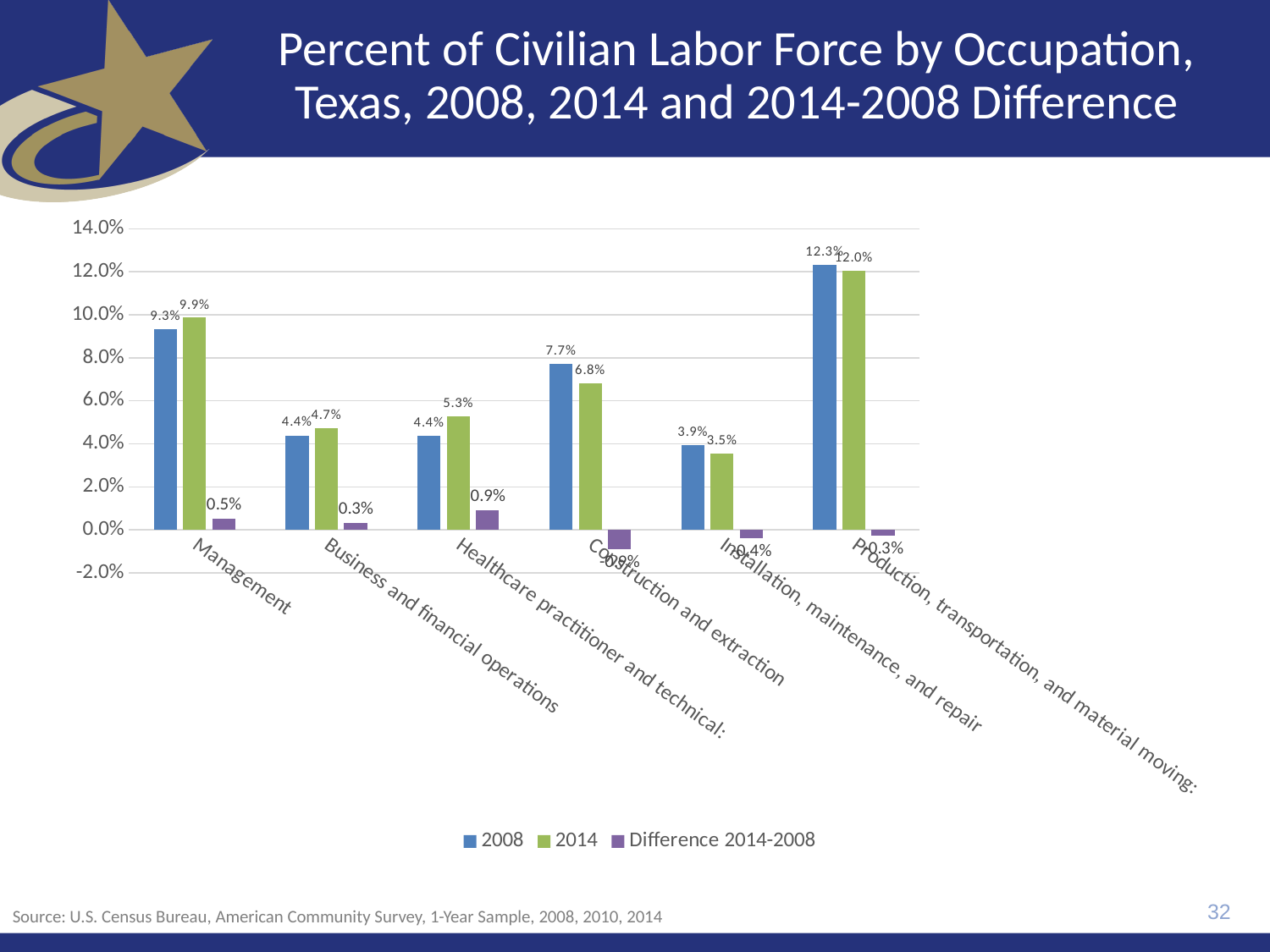
How many occupation categories are shown on the x axis? 6 What is the difference between the 2008 and 2014 values for Construction and extraction? 0.9% What is the 2014 value for Management? 9.9% Is the 2014 value for Production, transportation, and material moving greater or less than 10.0%? greater For Construction and extraction, which is larger: the 2008 value or the 2014 value? 2008 How many series does the legend list? 3 Which occupation has the highest 2008 value? Production, transportation, and material moving What is the 2008 value for Construction and extraction? 7.7% What is the Difference 2014-2008 value for Healthcare practitioner and technical? 0.9% What are the three entries in the chart's legend? 2008, 2014, Difference 2014-2008 What kind of chart is shown on the slide? bar chart Which occupation has the lowest 2014 value? Installation, maintenance, and repair